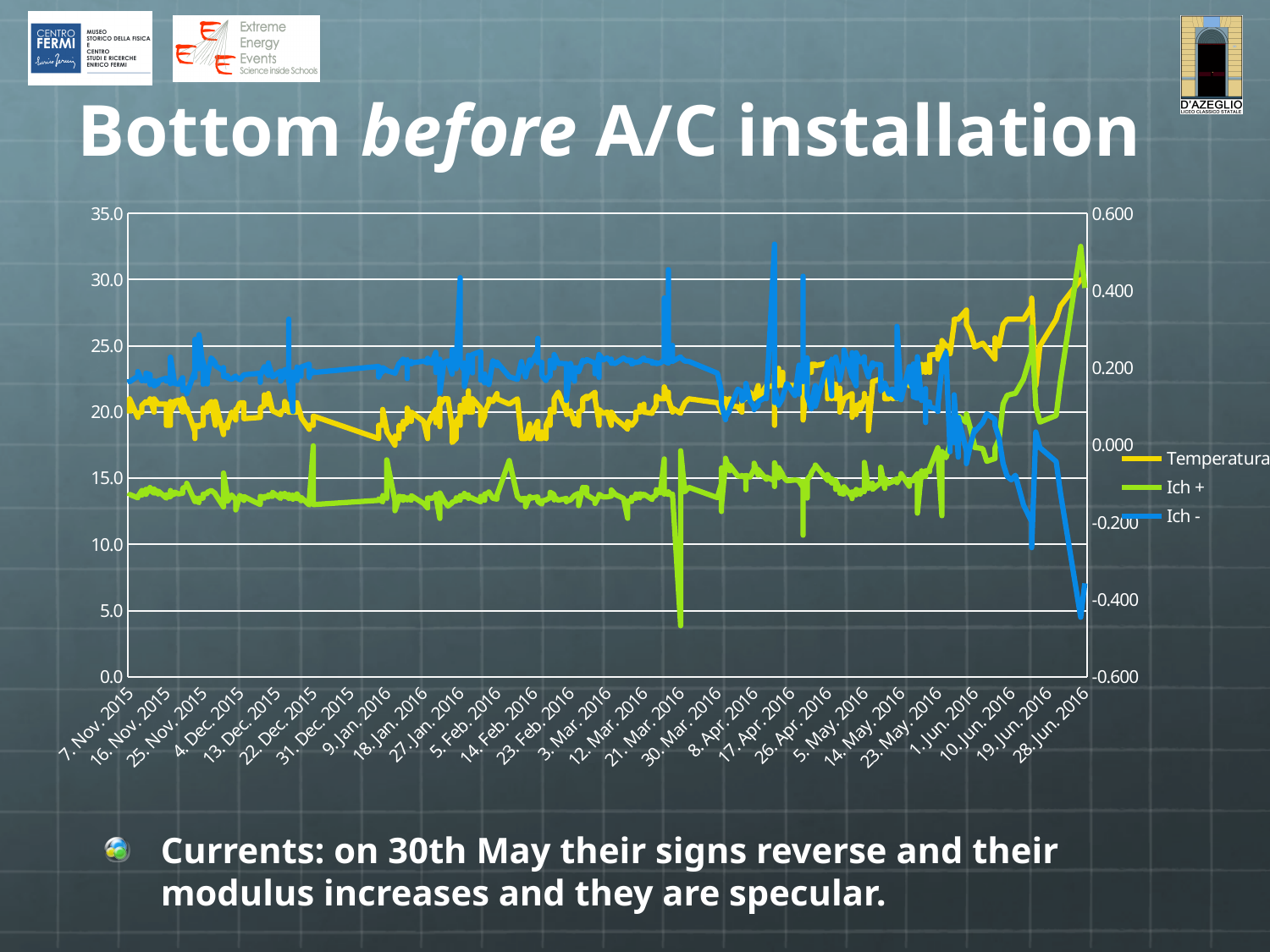
Which series are listed in the chart legend? Temperatura, Ich +, Ich - Is the peak Ich + value in late June 2016 greater or less than 0.400 on the right axis? greater What kind of chart is shown on the slide? line chart How many series does the chart legend list? 3 Is the lowest Ich - value in late June 2016 greater or less than -0.200 on the right axis? less Does the Ich - series rise or fall during June 2016? fall Is the Temperatura value at the start of the chart (7 Nov 2015) greater or less than 15.0 on the left axis? greater Which colour is used for the Temperatura series? yellow Does the Temperatura series overall rise or fall from November 2015 to June 2016? rise What is the first date label on the x axis? 7. Nov. 2015